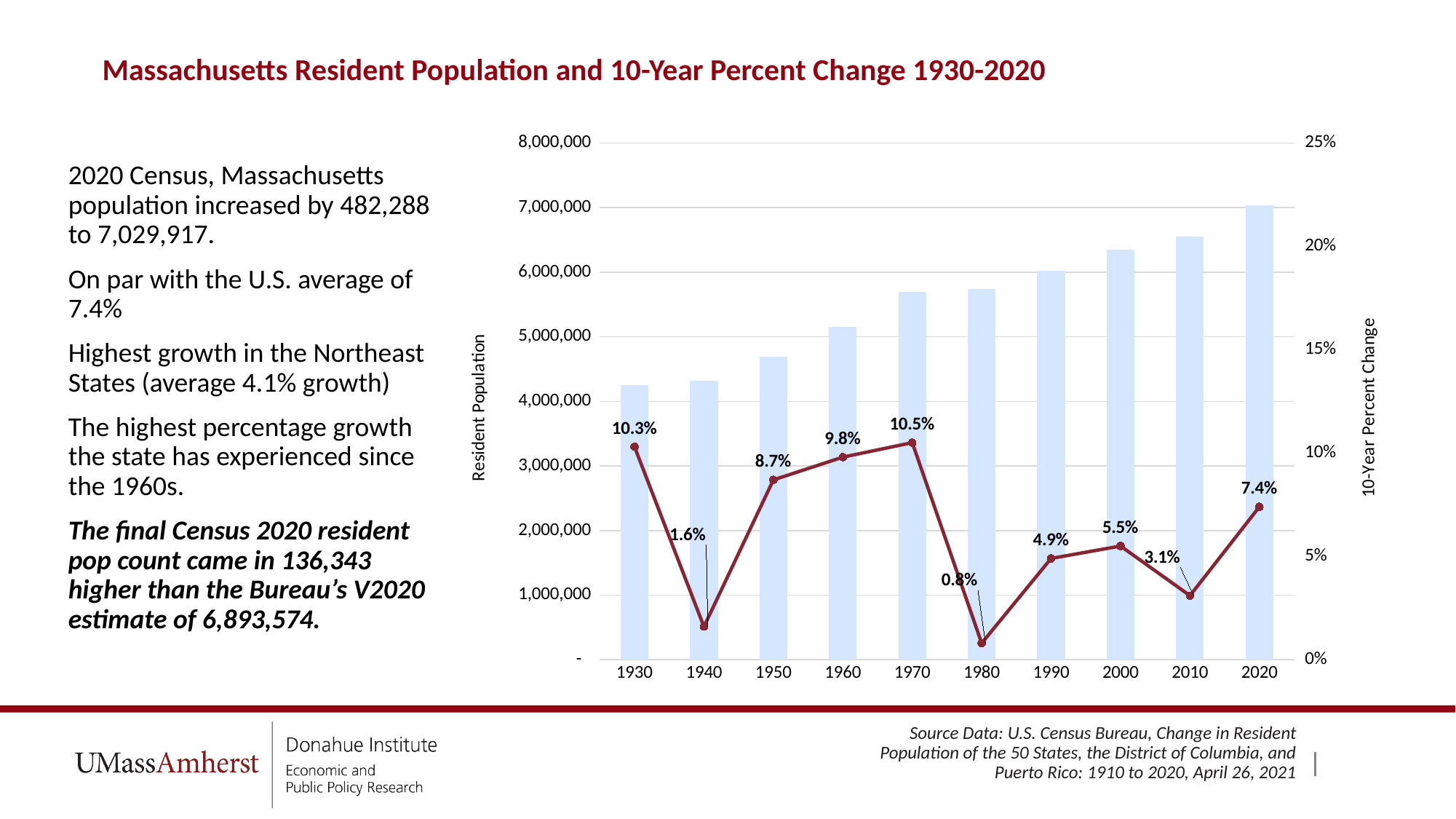
What is the difference in percentage points between the 10-year percent change for 1970 and for 1980? 9.7 Is the resident population bar for 1930 greater or less than 5,000,000? less Which year has the highest 10-year percent change on the line? 1970 Which is larger, the 10-year percent change for 2000 or for 2010? 2000 What is the 10-year percent change shown for 1980? 0.8% What kind of chart is used on this slide? Combined bar and line chart What is the 10-year percent change shown for 2020? 7.4% What is the 10-year percent change shown for 1970? 10.5% Do the resident population bars generally rise or fall from 1930 to 2020? rise Is the resident population bar for 2010 greater or less than 6,000,000? greater Which year has the lowest 10-year percent change on the line? 1980 How many years are shown on the x axis of the chart? 10